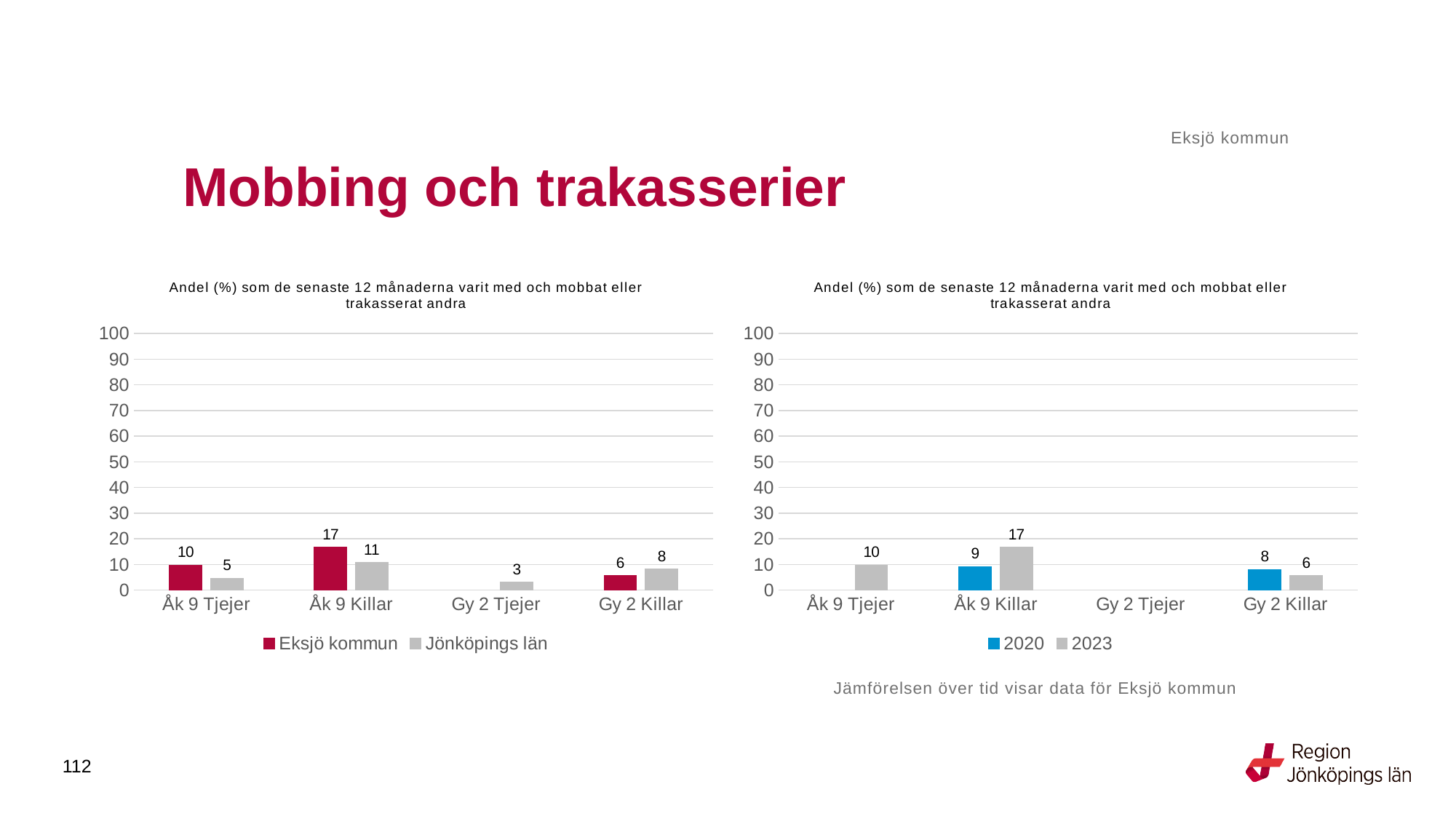
In the left chart, which category has the lowest value for Jönköpings län? Gy 2 Tjejer In the right chart, which is larger for Gy 2 Killar: 2020 or 2023? 2020 In the left chart, which is larger for Gy 2 Killar: Eksjö kommun or Jönköpings län? Jönköpings län How many series does the legend of the right chart list? 2 What kind of chart is the left chart? Bar chart In the left chart, what is the difference between Eksjö kommun and Jönköpings län for Åk 9 Tjejer? 5 In the left chart, what is the value for Jönköpings län for Gy 2 Tjejer? 3 In the left chart, what is the value for Eksjö kommun for Åk 9 Killar? 17 In the right chart, what is the difference between 2023 and 2020 for Åk 9 Killar? 8 In the right chart, what is the value for 2023 for Gy 2 Killar? 6 In the right chart, what is the value for 2020 for Åk 9 Killar? 9 In the left chart, which category has the highest value for Jönköpings län? Åk 9 Killar